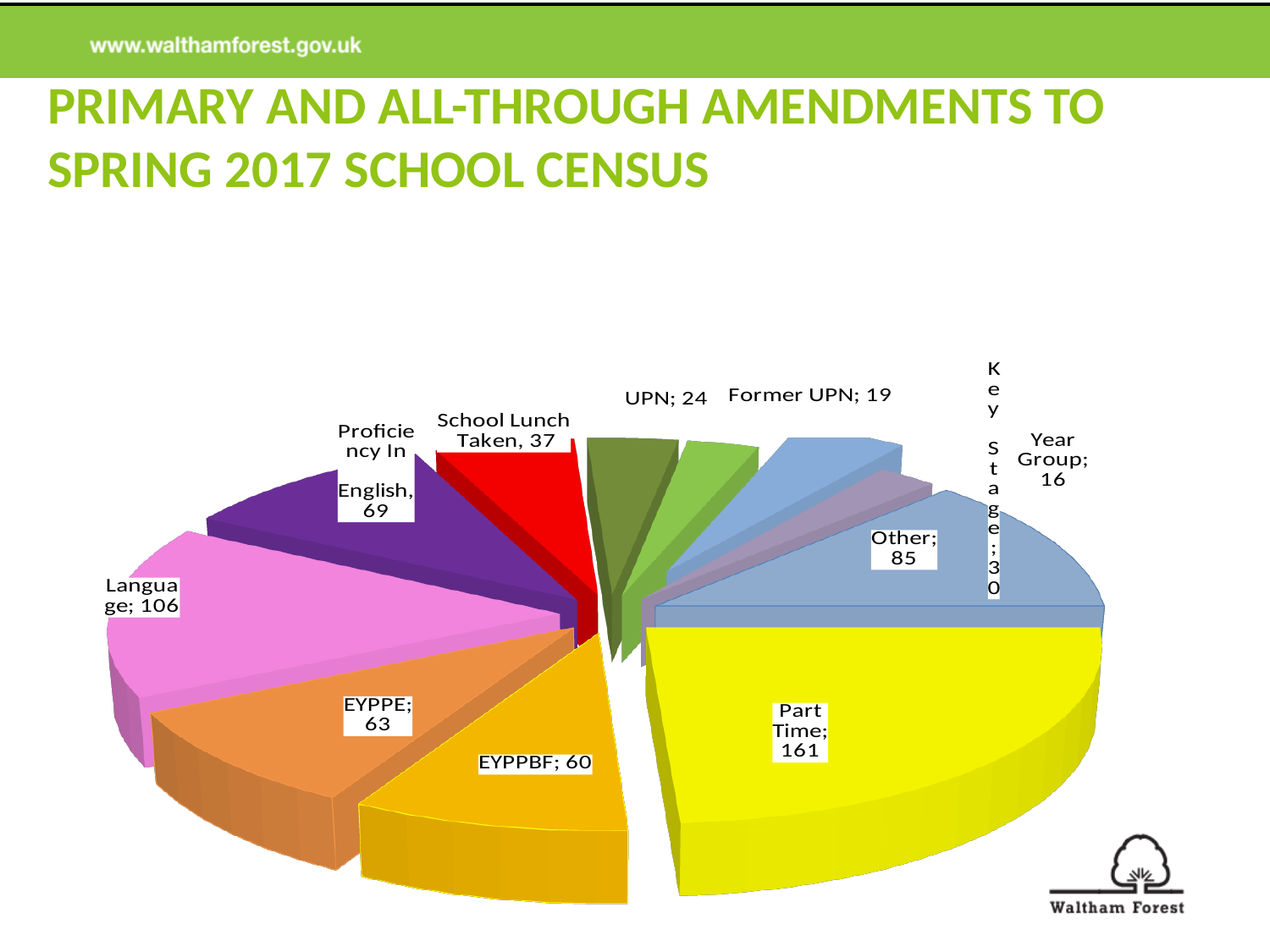
What is the value for Year Group? 16 Which is larger, EYPPE or EYPPBF? EYPPE What is the difference between the values for UPN and Former UPN? 5 What is the value for Part Time? 161 Which category has the largest slice? Part Time What kind of chart is shown on the slide? Pie chart What is the value for School Lunch Taken? 37 What is the value for Other? 85 What is the value for Language? 106 What is the difference between the values for Part Time and Language? 55 How many slices does the pie chart have? 11 Which category has the smallest slice? Year Group